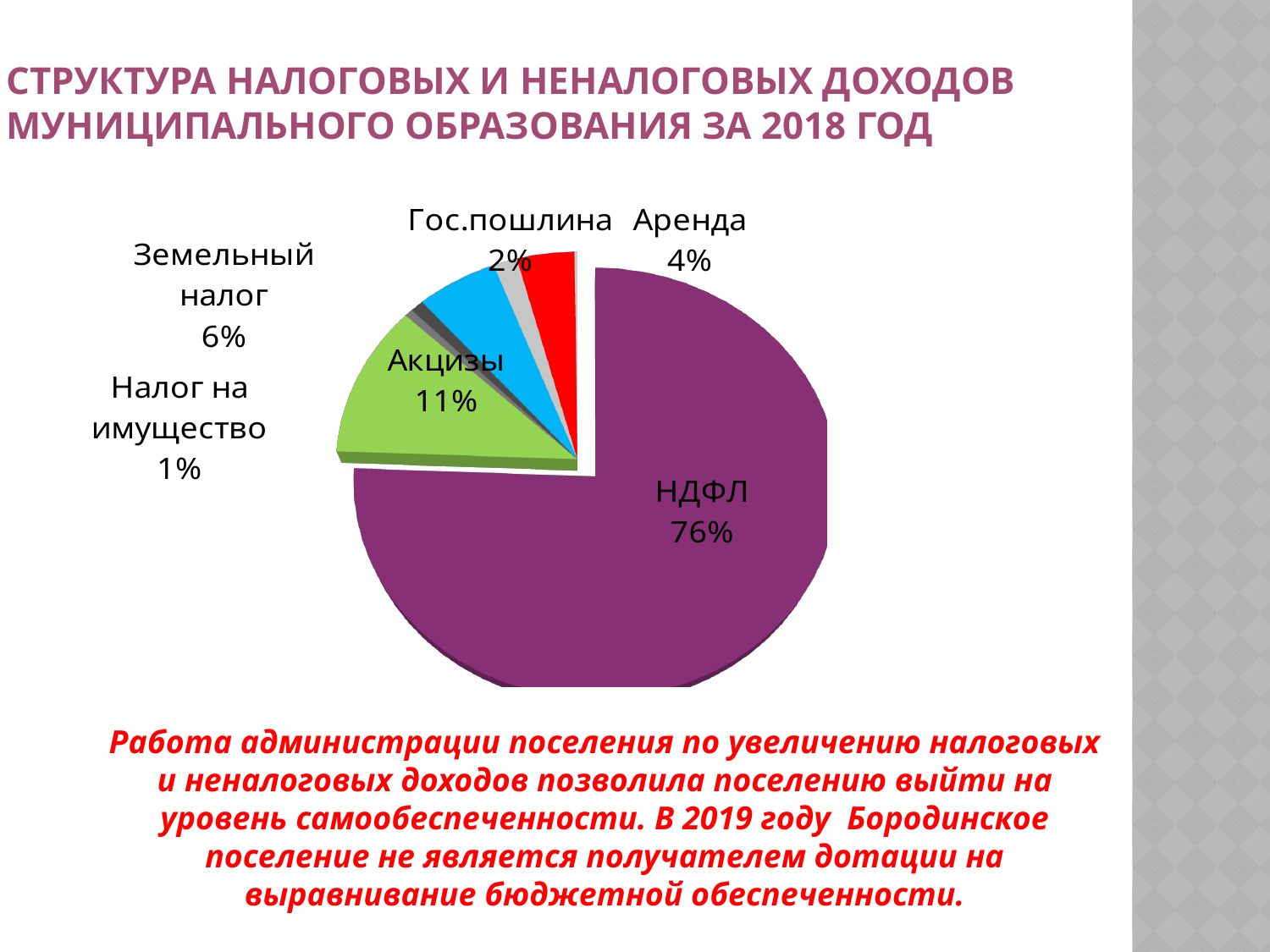
What share of the pie does НДФЛ account for? 76% What colour is the НДФЛ slice? Purple Which category has the largest slice of the pie? НДФЛ What kind of chart is shown on the slide? Pie chart What is the share for Гос.пошлина? 2% What is the share for Земельный налог? 6% What percentage is shown for Аренда? 4% What percentage is shown for Акцизы? 11% What is the difference in percentage points between НДФЛ and Акцизы? 65 Which is larger, the share for Земельный налог or the share for Аренда? Земельный налог